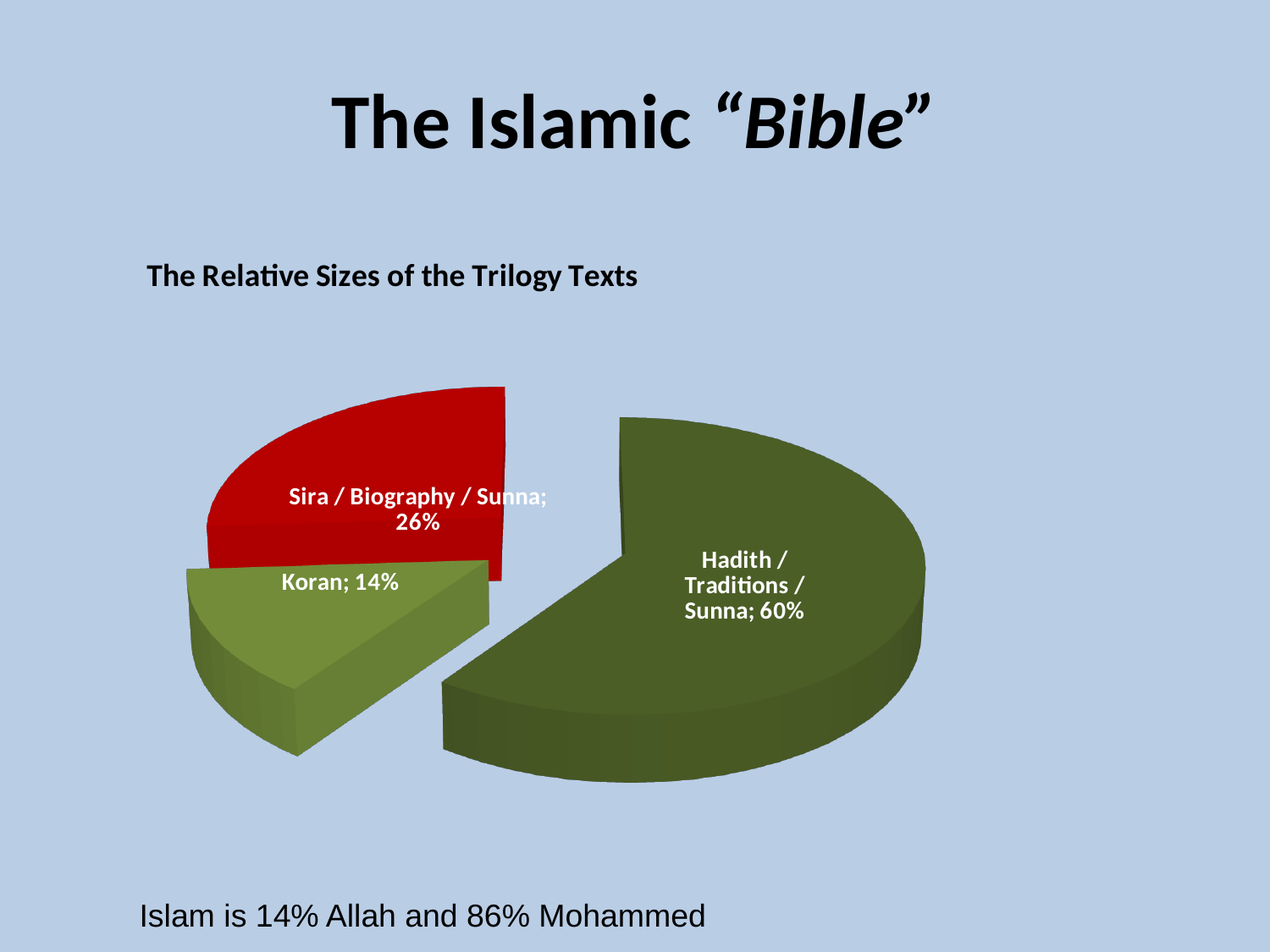
Which is larger, the Koran slice or the Sira / Biography / Sunna slice? Sira / Biography / Sunna What colour is the Sira / Biography / Sunna slice? Red What is the difference in percentage points between the Hadith / Traditions / Sunna slice and the Sira / Biography / Sunna slice? 34 Which slice of the pie is the smallest? Koran What is the title of the chart? The Relative Sizes of the Trilogy Texts How many slices does the pie chart have? 3 What kind of chart is shown on the slide? Pie chart Which slice of the pie is the largest? Hadith / Traditions / Sunna What percentage does the Sira / Biography / Sunna slice represent? 26% What is the difference in percentage points between the Sira / Biography / Sunna slice and the Koran slice? 12 What percentage does the Koran slice represent? 14% What percentage does the Hadith / Traditions / Sunna slice represent? 60%